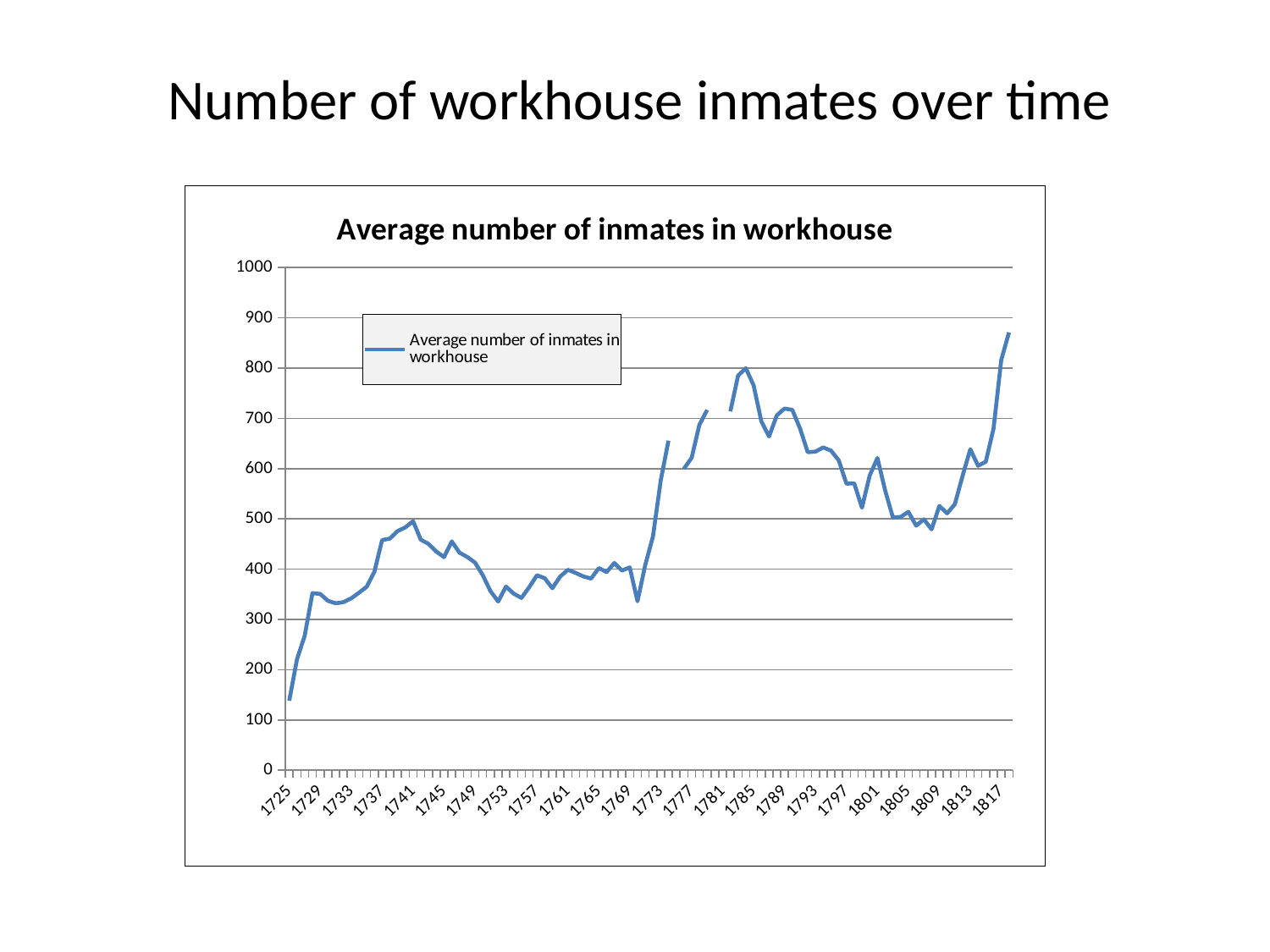
Is the value for 1725 greater or less than 200? less Is the value for 1813 greater or less than 600? greater Which is larger, the value for 1785 or the value for 1745? 1785 How many series does the legend list? 1 Is the value for 1817 greater or less than 800? greater What is the title of the chart? Average number of inmates in workhouse Which year has the lowest average number of inmates? 1725 What kind of chart is shown on the slide? line chart What colour is the plotted line? blue Which year has the highest average number of inmates? 1818